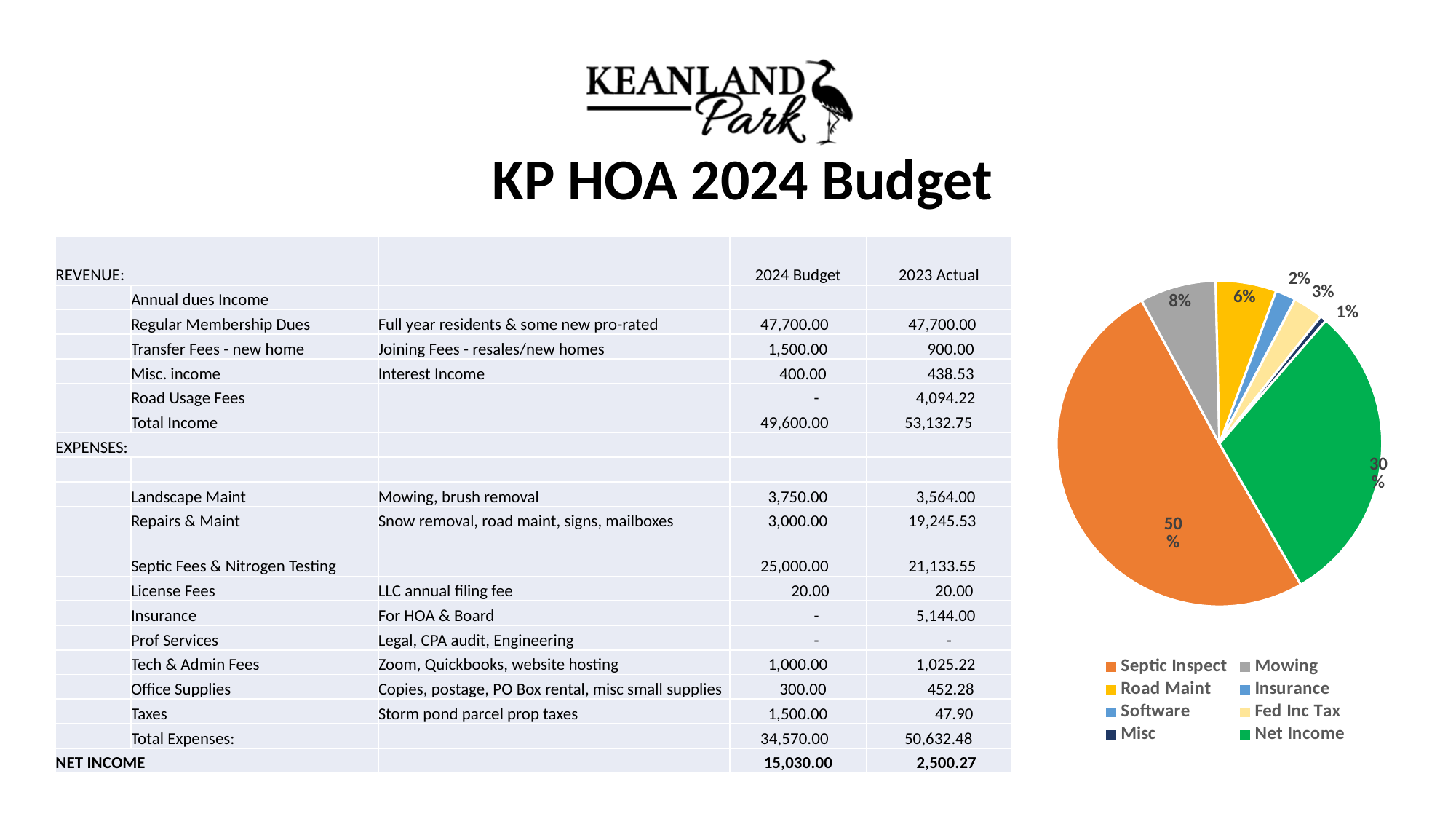
What share of the pie does Net Income take? 30% What kind of chart is shown on the right of the slide? pie chart How many percentage points larger is the Septic Inspect slice than the Net Income slice? 20 How many entries does the pie chart legend list? 8 What share of the pie does Fed Inc Tax take? 3% What share of the pie does Mowing take? 8% Which category has the largest slice of the pie? Septic Inspect Which slice is larger, Mowing or Road Maint? Mowing What colour is the Net Income slice in the pie chart? green